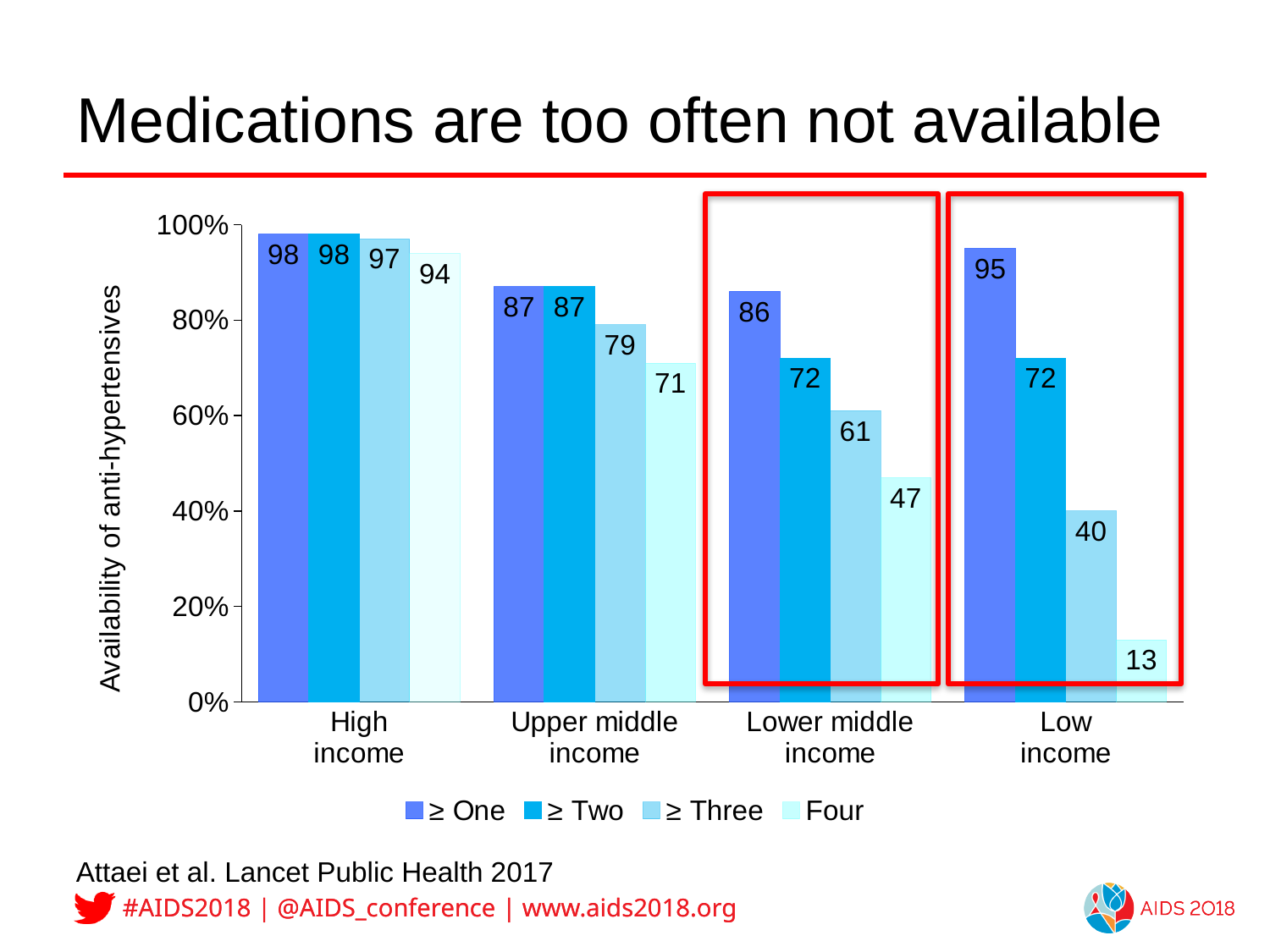
Is the value for "≥ Three" in the Low income category greater or less than 60%? less What is the value for "≥ One" in the Upper middle income category? 87 How many series does the legend list? 4 Which is larger: the "Four" value for Upper middle income or the "Four" value for Lower middle income? Upper middle income What is the label of the y axis? Availability of anti-hypertensives Which income category has the highest value for "≥ Three"? High income Which income category has the lowest value for "Four"? Low income What kind of chart is shown on the slide? Bar chart What is the value for "≥ Three" in the Lower middle income category? 61 How many income categories are shown on the x axis? 4 What is the difference between the "≥ One" and "Four" values in the Low income category? 82 What is the value for "Four" in the Low income category? 13